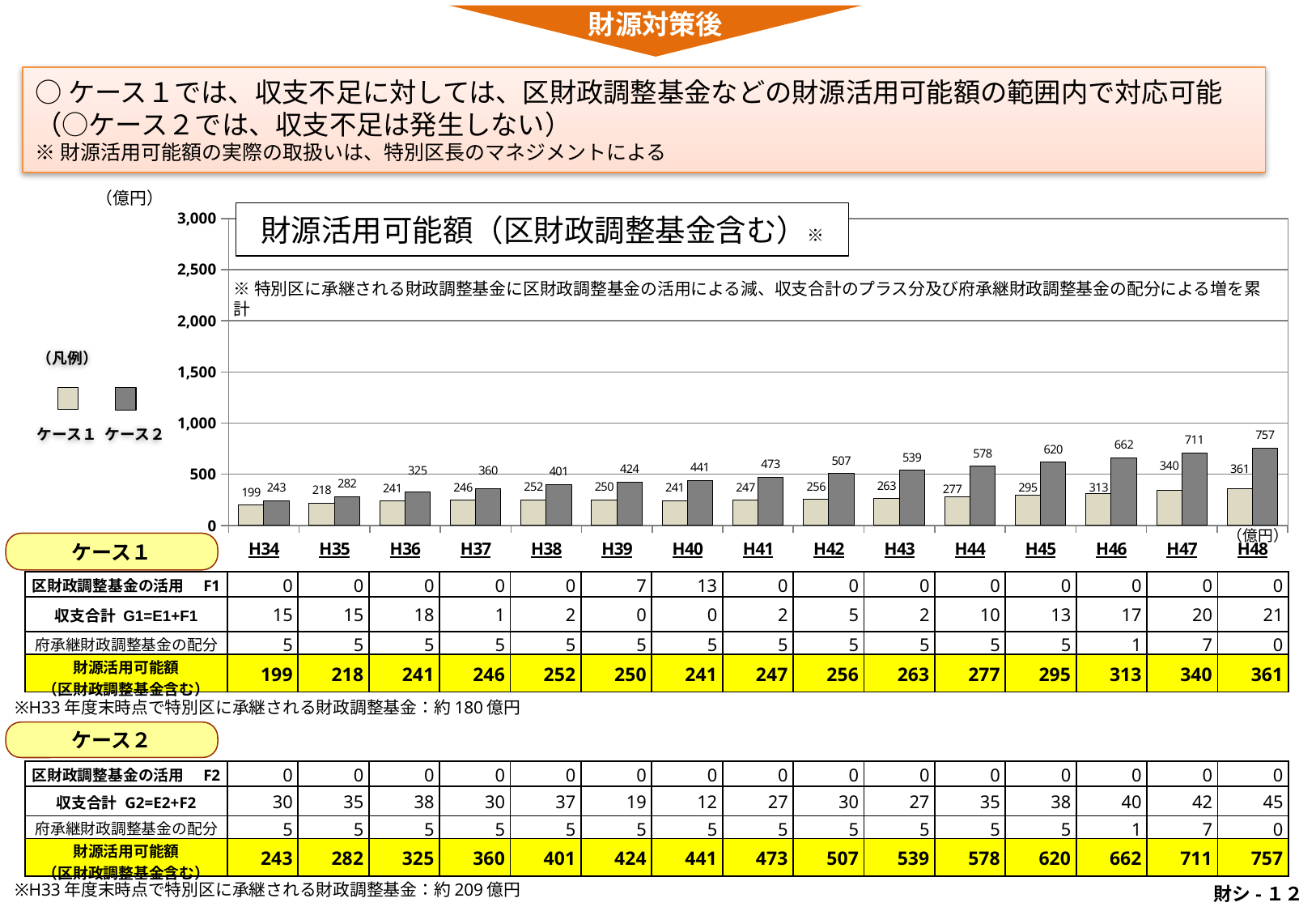
What is the value for ケース1 in H34? 199 How many fiscal years (categories) are plotted on the x axis of the chart? 15 What is the value for ケース2 in H40? 441 What is the difference between the ケース2 and ケース1 values in H48? 396 Which is larger in H42: the ケース1 value or the ケース2 value? ケース2 Do the ケース2 values rise or fall from H34 to H48? rise In which year is the ケース2 value highest? H48 What is the title of the chart? 財源活用可能額（区財政調整基金含む） What type of chart is shown on the slide? bar chart In which year is the ケース1 value lowest? H34 What is the value for ケース2 in H48? 757 How many series does the chart's legend list? 2